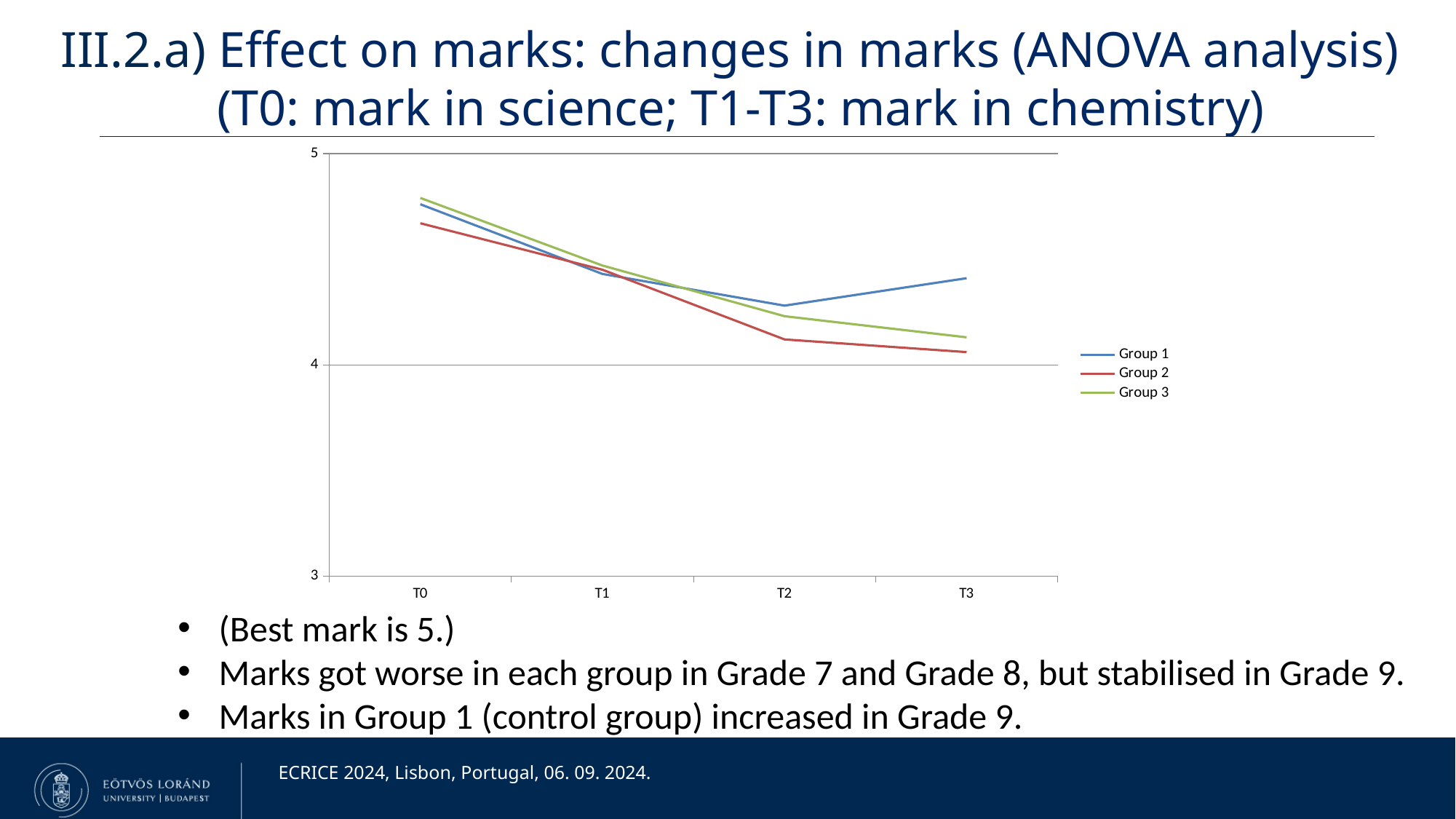
What kind of chart is shown on the slide? line chart How many time points are shown on the x axis? 4 Is the value for Group 2 at T3 greater or less than 4? greater Which group has the highest mark at T3? Group 1 At T0, which is larger: the mark for Group 3 or the mark for Group 2? Group 3 Is the value for Group 1 at T0 greater or less than 5? less At T3, which is larger: the mark for Group 1 or the mark for Group 2? Group 1 How many series does the legend list? 3 Do the marks for Group 1 rise or fall from T2 to T3? rise Which group has the lowest mark at T3? Group 2 Which colour is used for the Group 3 line? green Do the marks for Group 2 rise or fall from T0 to T3? fall